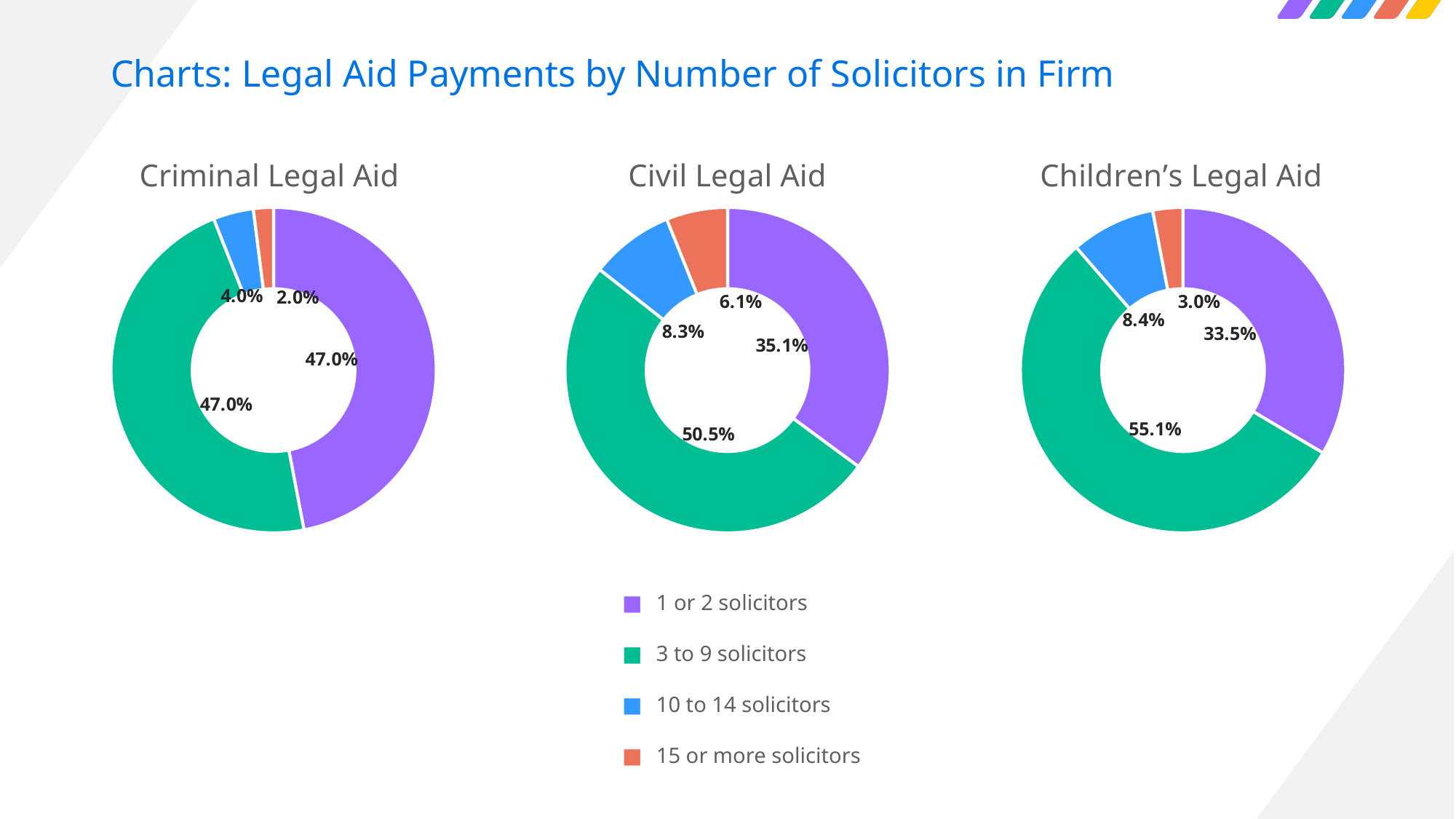
How many firm size categories does the legend list? 4 Which colour represents firms with 15 or more solicitors in the legend? Orange In the Civil Legal Aid chart, what is the difference between the shares for 3 to 9 solicitors and 1 or 2 solicitors? 15.4% In the Children's Legal Aid chart, what share of payments went to firms with 1 or 2 solicitors? 33.5% In the Criminal Legal Aid chart, which firm size category has the smallest share? 15 or more solicitors In the Criminal Legal Aid chart, what share of payments went to firms with 10 to 14 solicitors? 4.0% In the Civil Legal Aid chart, which firm size category has the smallest share? 15 or more solicitors In the Children's Legal Aid chart, which firm size category has the largest share? 3 to 9 solicitors What type of chart is used for Criminal Legal Aid? Pie (donut) chart In the Civil Legal Aid chart, what share of payments went to firms with 15 or more solicitors? 6.1% In the Civil Legal Aid chart, what share of payments went to firms with 3 to 9 solicitors? 50.5% In the Children's Legal Aid chart, which is larger: the share for 10 to 14 solicitors or the share for 15 or more solicitors? 10 to 14 solicitors